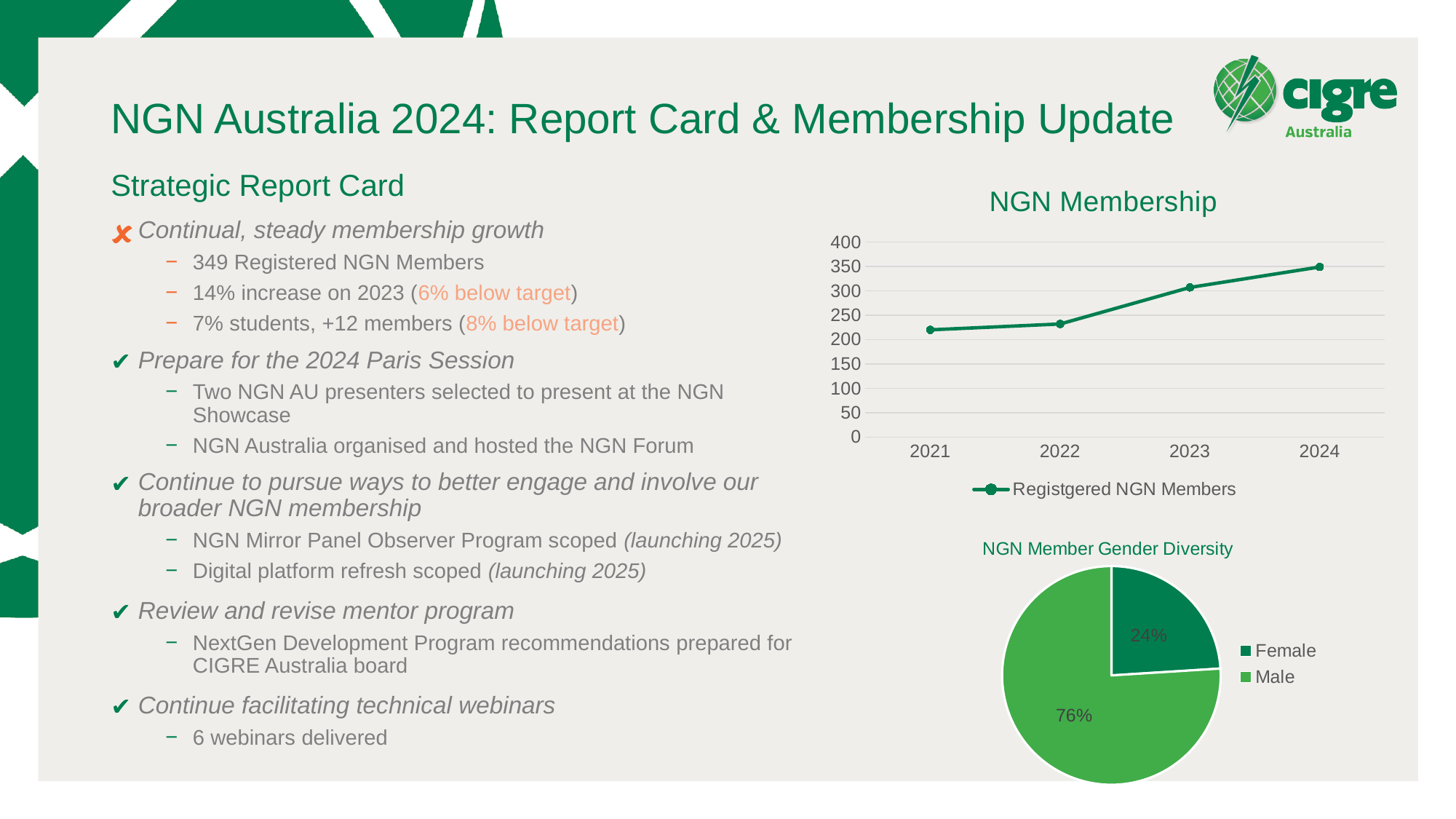
What type of chart is the NGN Membership chart? line chart In the NGN Member Gender Diversity chart, what share of members is Female? 24% In the NGN Membership chart, is the value for 2024 greater or less than 300? greater In the NGN Membership chart, which year has the lowest number of registered NGN members? 2021 In the NGN Member Gender Diversity chart, what share of members is Male? 76% In the NGN Member Gender Diversity chart, what is the difference between the Male and Female shares? 52% In the NGN Membership chart, how many years are plotted on the x axis? 4 In the NGN Membership chart, do registered NGN members rise or fall from 2021 to 2024? rise In the NGN Membership chart, is the value for 2021 greater or less than 250? less In the NGN Membership chart, what series name is shown in the legend? Registgered NGN Members What type of chart is the NGN Member Gender Diversity chart? pie chart In the NGN Membership chart, which year has the highest number of registered NGN members? 2024